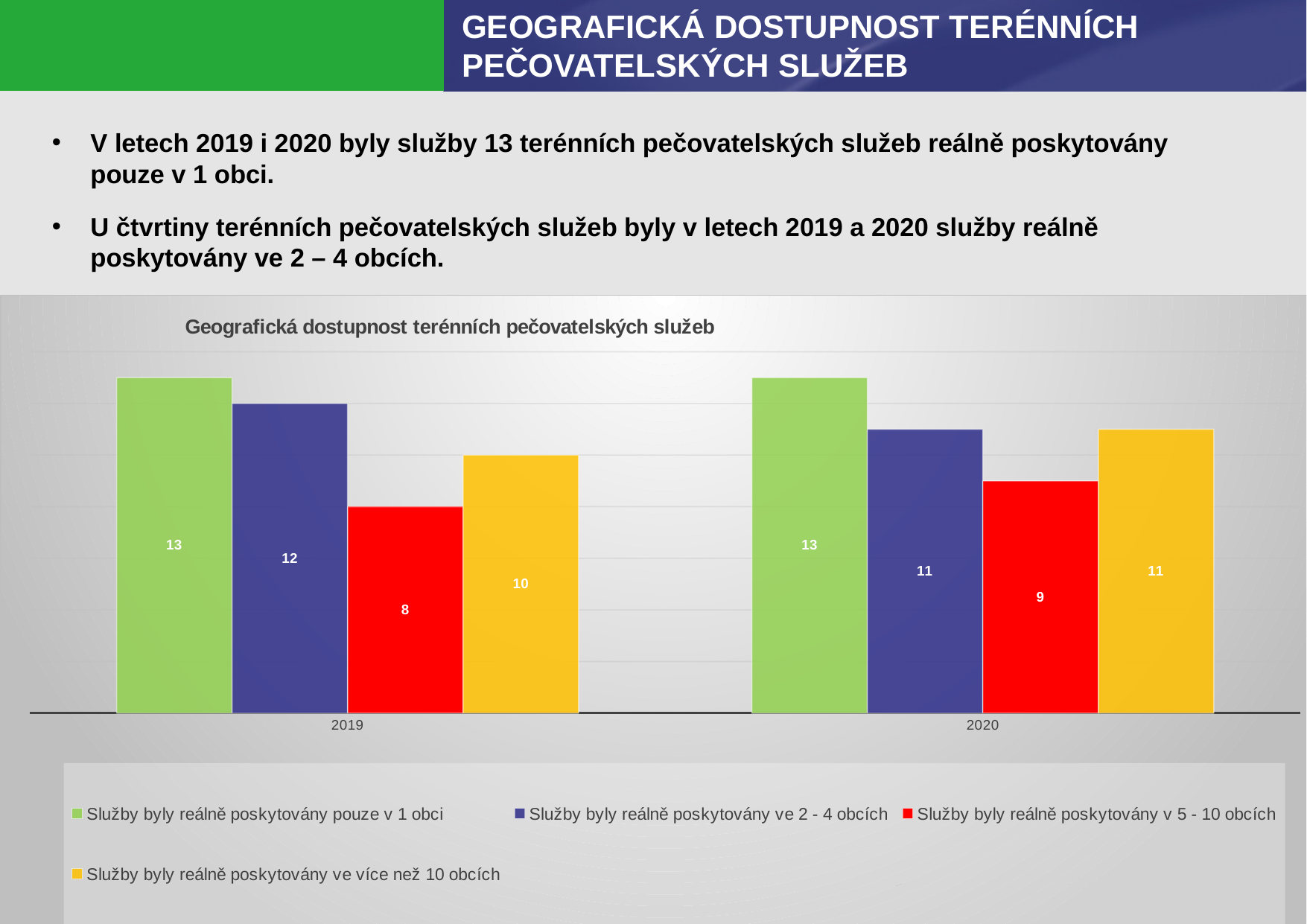
What is the value for "Služby byly reálně poskytovány v 5 - 10 obcích" in 2020? 9 Does the value for "Služby byly reálně poskytovány v 5 - 10 obcích" rise or fall from 2019 to 2020? Rise How many categories are shown on the x axis? 2 Which is larger: the value for "Služby byly reálně poskytovány ve 2 - 4 obcích" in 2019 or in 2020? 2019 Which series has the lowest value in 2019? Služby byly reálně poskytovány v 5 - 10 obcích What is the value for "Služby byly reálně poskytovány ve 2 - 4 obcích" in 2019? 12 Which series has the highest value in 2020? Služby byly reálně poskytovány pouze v 1 obci What is the value for "Služby byly reálně poskytovány ve více než 10 obcích" in 2019? 10 What kind of chart is shown on the slide? Bar chart How many series does the legend list? 4 What is the difference between the values for "Služby byly reálně poskytovány pouze v 1 obci" and "Služby byly reálně poskytovány v 5 - 10 obcích" in 2019? 5 What is the title of the chart? Geografická dostupnost terénních pečovatelských služeb